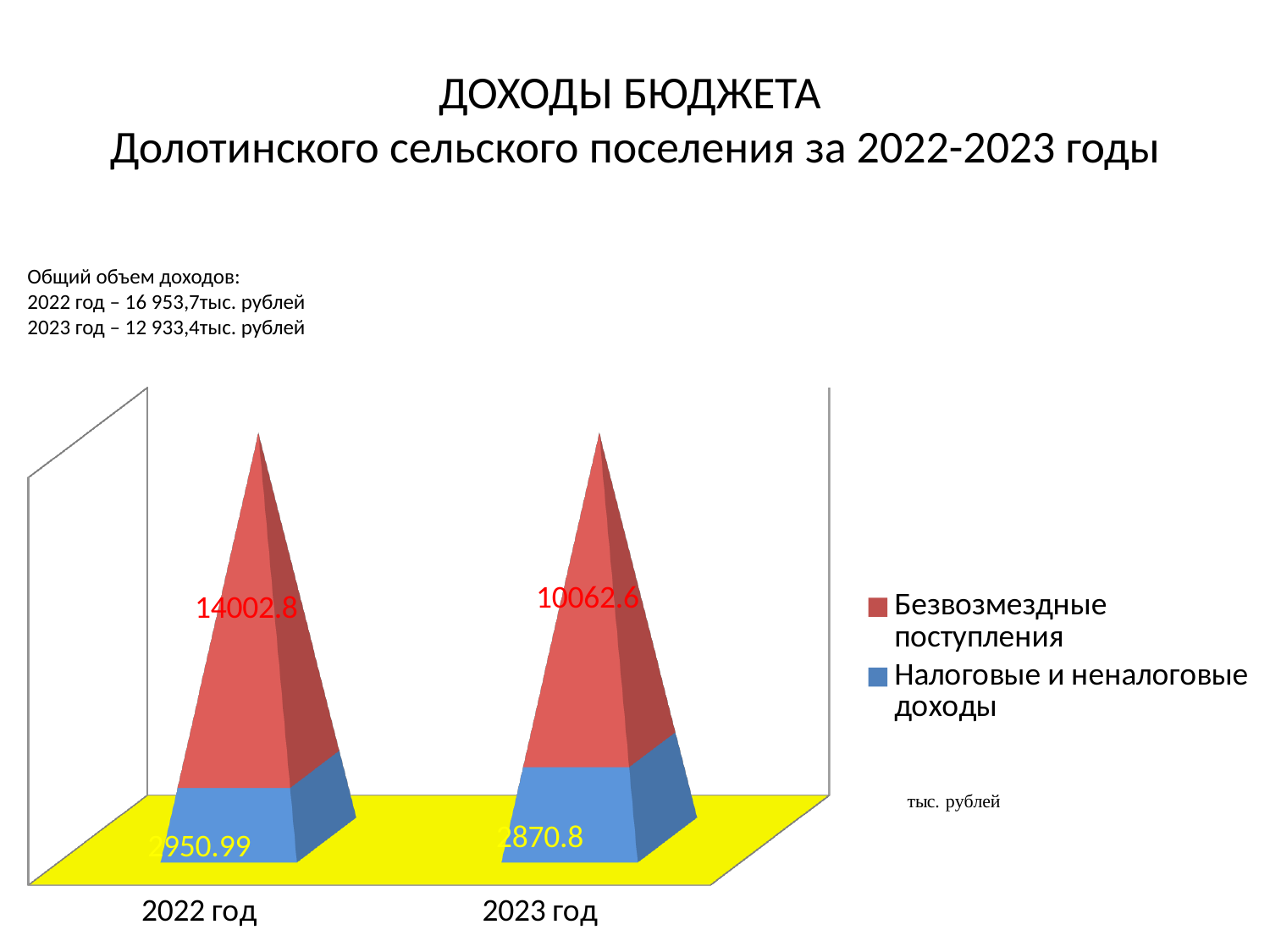
Which is larger: Безвозмездные поступления in 2023 год or Налоговые и неналоговые доходы in 2022 год? Безвозмездные поступления in 2023 год What is the value of Налоговые и неналоговые доходы for 2022 год? 2950.99 How many series does the legend list? 2 By how much did Безвозмездные поступления decrease from 2022 год to 2023 год? 3940.2 What is the value of Налоговые и неналоговые доходы for 2023 год? 2870.8 What kind of chart is shown on the slide? Stacked bar chart What is the total of the stacked bar for 2023 год? 12933.4 What is the value of Безвозмездные поступления for 2022 год? 14002.8 What is the value of Безвозмездные поступления for 2023 год? 10062.6 Which year has the higher value for Безвозмездные поступления? 2022 год Which year has the lower value for Налоговые и неналоговые доходы? 2023 год How many categories (years) are shown on the x axis? 2